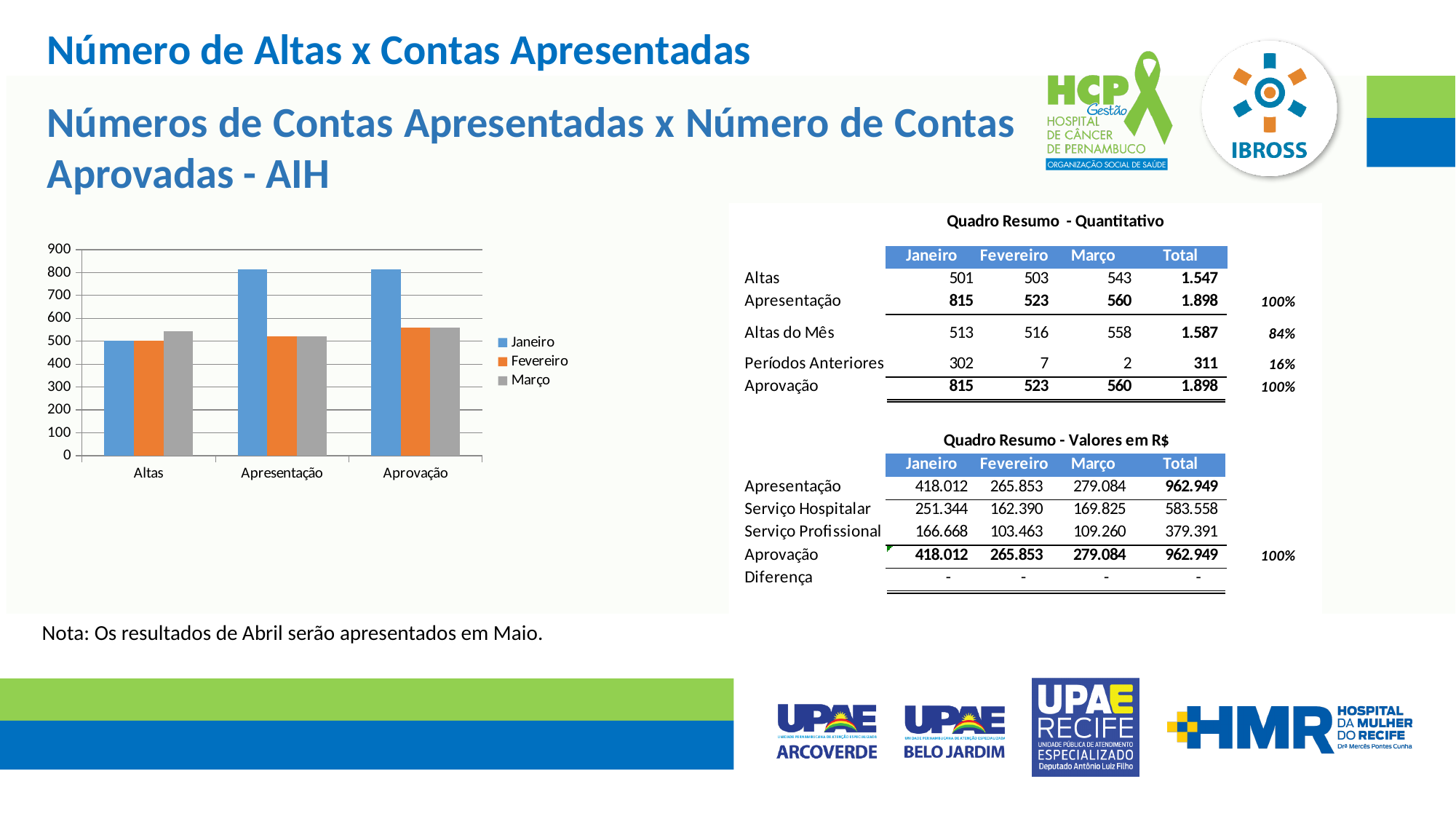
Is the value for Janeiro in the Apresentação category greater or less than 700? greater What is the difference between the Janeiro and Fevereiro values for Apresentação? 292 What kind of chart is shown on the slide? bar chart How many categories are shown on the x axis of the chart? 3 Is the value for Fevereiro in the Altas category greater or less than 600? less In the Apresentação category, which is larger: Janeiro or Fevereiro? Janeiro How many series does the chart's legend list? 3 What are the legend entries of the chart? Janeiro, Fevereiro, Março Which month has the highest value in the Aprovação category? Janeiro Is the value for Março in the Aprovação category greater or less than 700? less Which colour represents Janeiro in the chart? blue According to the slide, what is the Janeiro value for Apresentação? 815